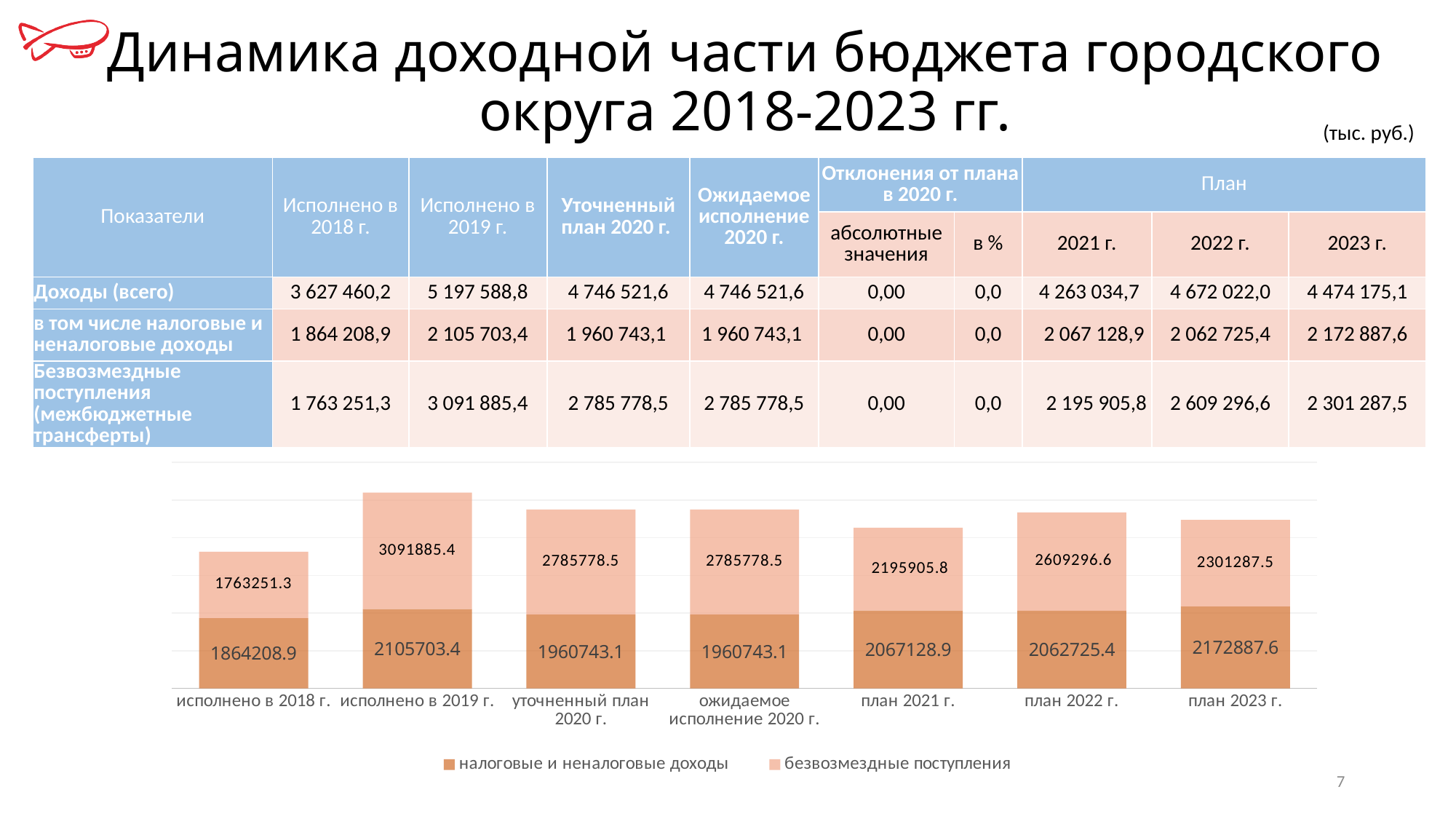
What is the difference between the безвозмездные поступления values for исполнено в 2019 г. and исполнено в 2018 г.? 1328634.1 What value does the chart show for безвозмездные поступления in план 2022 г.? 2609296.6 How many series does the chart legend list? 2 In which category is the безвозмездные поступления value highest on the chart? исполнено в 2019 г. What value does the chart show for безвозмездные поступления in ожидаемое исполнение 2020 г.? 2785778.5 What value does the chart show for налоговые и неналоговые доходы in исполнено в 2018 г.? 1864208.9 For план 2021 г., which is larger: налоговые и неналоговые доходы or безвозмездные поступления? безвозмездные поступления Which series is shown in the darker orange colour in the chart? налоговые и неналоговые доходы What is the total of the stacked bar for план 2023 г.? 4474175.1 How many categories are shown on the x axis of the chart? 7 In which category is the налоговые и неналоговые доходы value lowest on the chart? исполнено в 2018 г. What kind of chart is shown on the slide? Stacked bar chart